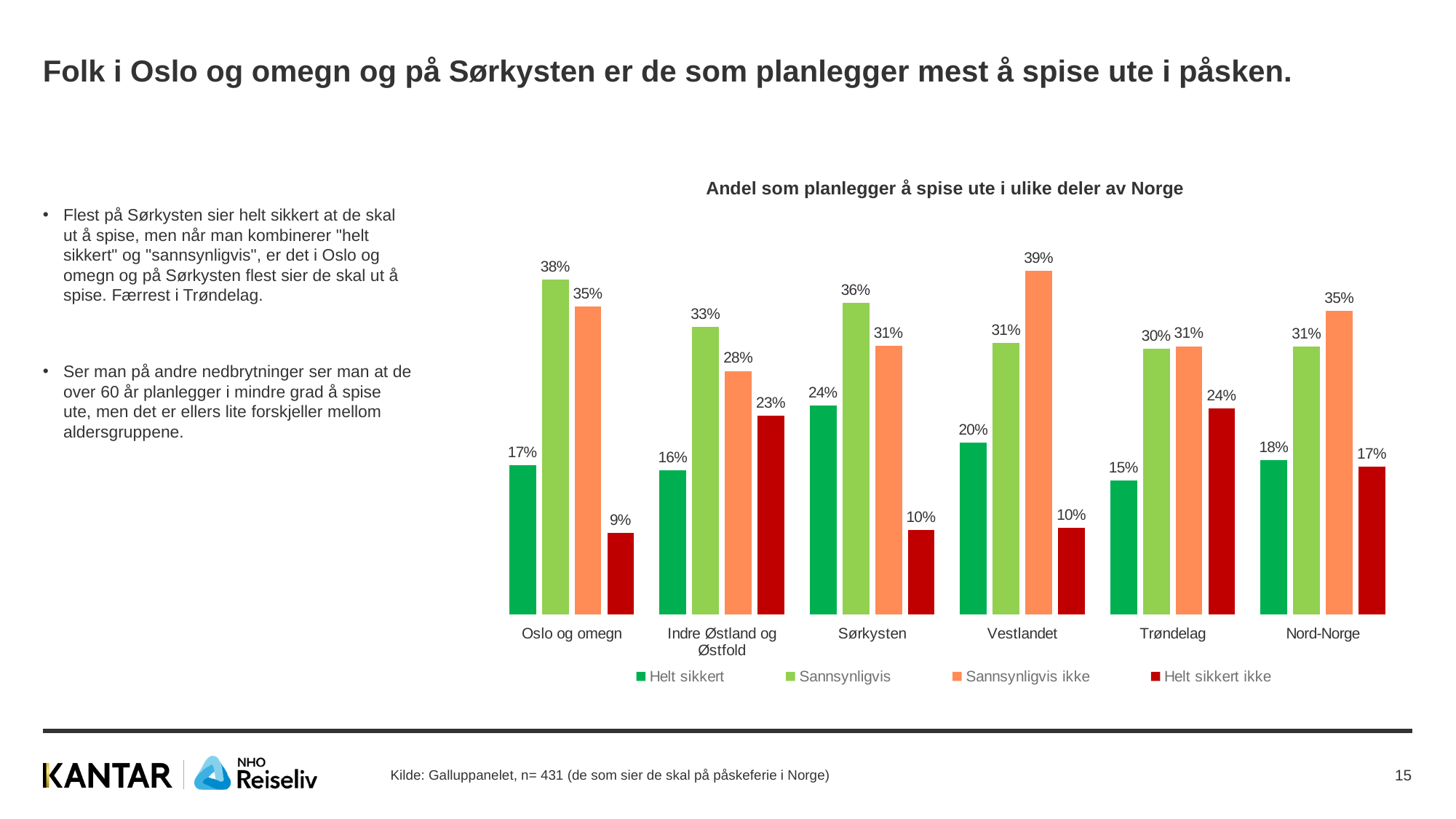
Which region has the highest value for "Helt sikkert ikke"? Trøndelag What is the difference between "Sannsynligvis" and "Helt sikkert" in Oslo og omegn? 21 percentage points Which region has the highest value for "Helt sikkert"? Sørkysten Which is larger in Nord-Norge: "Sannsynligvis" or "Sannsynligvis ikke"? Sannsynligvis ikke How many regions are shown on the x axis? 6 Which region has the lowest value for "Helt sikkert"? Trøndelag How many series does the legend list? 4 What is the value for "Sannsynligvis" in Indre Østland og Østfold? 33% What is the value for "Helt sikkert ikke" in Oslo og omegn? 9% What is the value for "Sannsynligvis ikke" in Vestlandet? 39% What kind of chart is shown on the slide? Bar chart What is the value for "Helt sikkert" in Sørkysten? 24%